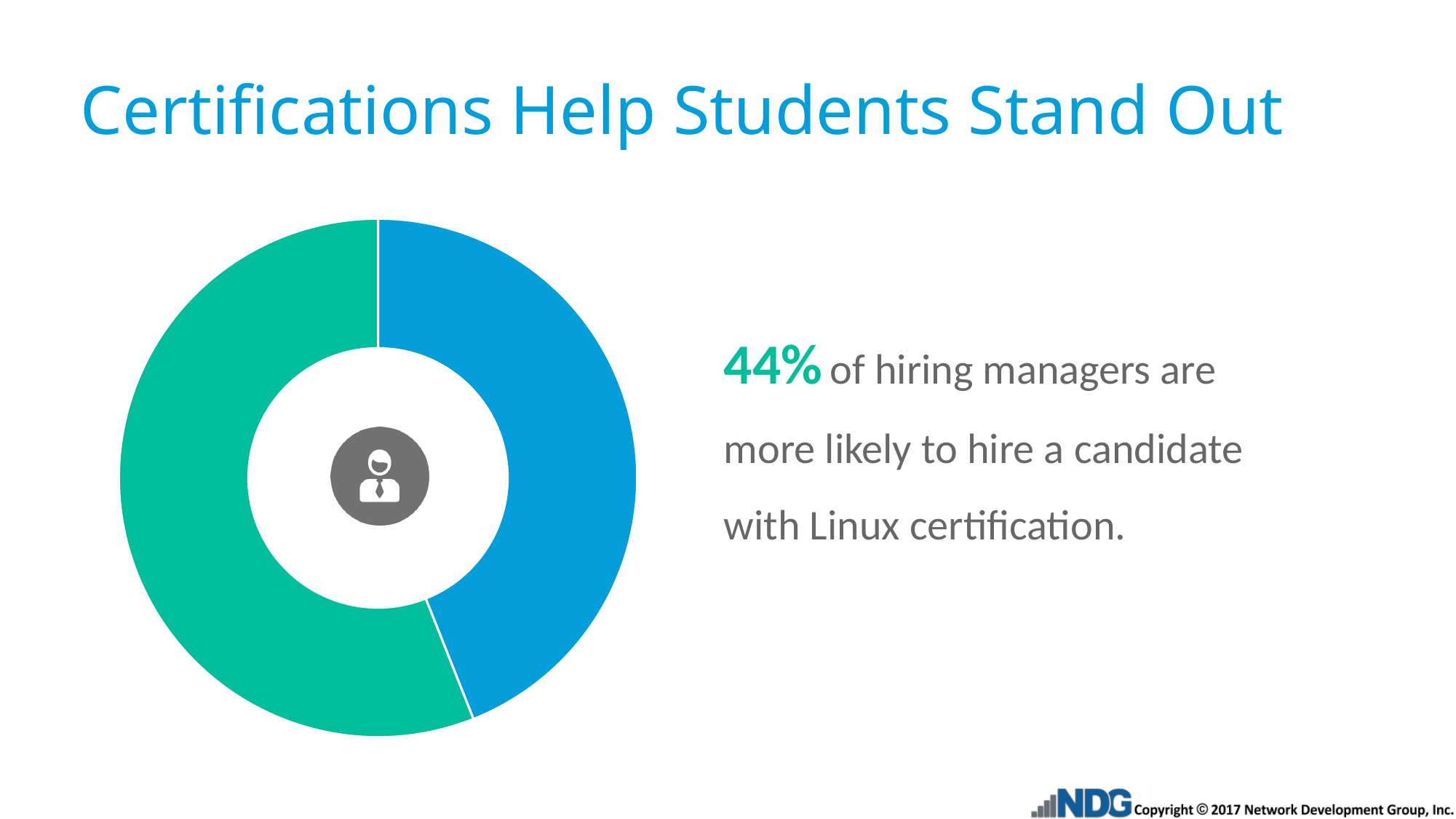
What kind of chart is shown on the slide? Donut (pie) chart Which colour slice takes up the smallest share of the donut chart? Blue What is the title of the slide containing the donut chart? Certifications Help Students Stand Out What percentage of hiring managers does the slide say are more likely to hire a candidate with Linux certification? 44% What icon is shown in the centre of the donut chart? A person (businessperson) icon How many slices does the donut chart have? 2 Which colour slice takes up the largest share of the donut chart? Green Which slice of the donut chart is larger, the green one or the blue one? Green